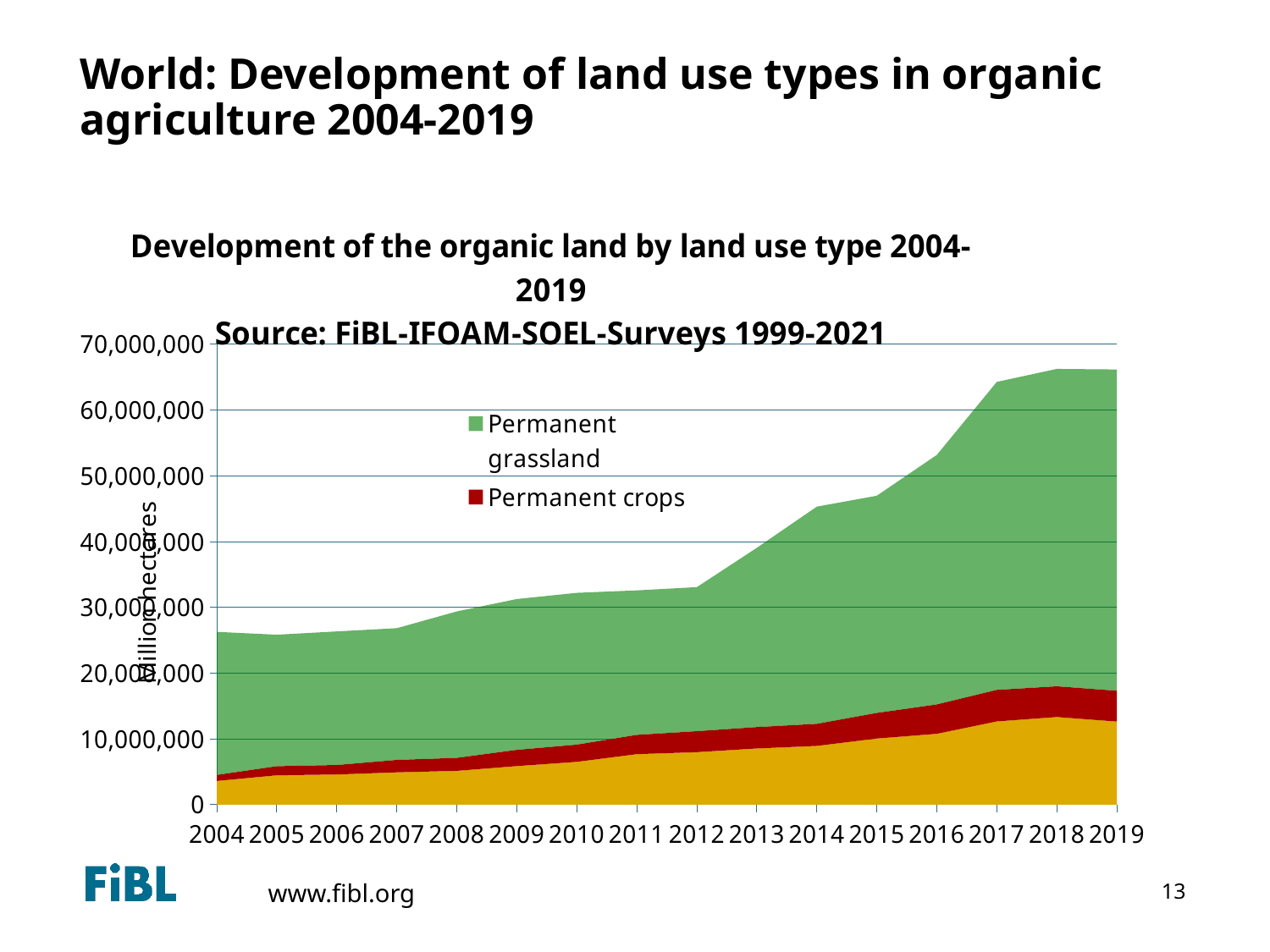
Is the total organic land area in 2004 greater or less than 30,000,000? less Is the total organic land area in 2014 greater or less than 40,000,000? greater What colour represents Permanent grassland in the chart? Green Is the total organic land area in 2016 greater or less than 50,000,000? greater Does the total organic land area rise or fall from 2004 to 2019? Rise What is the label on the chart's y axis? Million hectares Which is larger, the total organic land area in 2017 or in 2013? 2017 How many series does the chart's legend list? 2 What kind of chart is shown on the slide? Stacked area chart How many years are shown along the x axis of the chart? 16